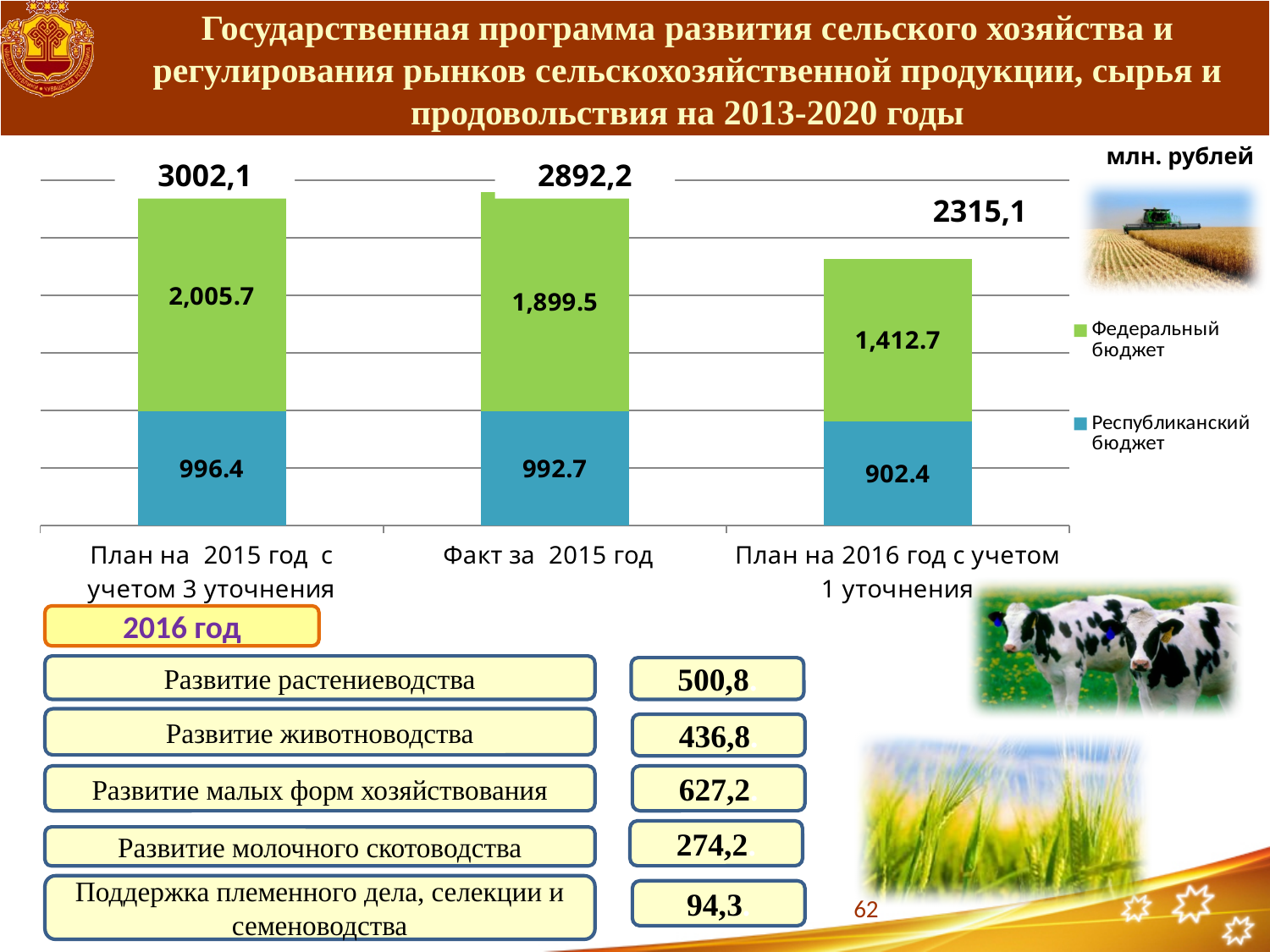
What is the value of Федеральный бюджет for План на 2016 год с учетом 1 уточнения? 1,412.7 What kind of chart is shown on the slide? stacked bar chart What is the value of Республиканский бюджет for Факт за 2015 год? 992.7 Which is larger: Федеральный бюджет for Факт за 2015 год or Федеральный бюджет for План на 2016 год с учетом 1 уточнения? Факт за 2015 год What is the total shown above the bar for Факт за 2015 год? 2892,2 What is the difference between the Республиканский бюджет values for Факт за 2015 год and План на 2016 год с учетом 1 уточнения? 90.3 Which category has the lowest total? План на 2016 год с учетом 1 уточнения How many categories are shown on the x axis of the chart? 3 Which category has the highest value for Республиканский бюджет? План на 2015 год с учетом 3 уточнения What is the value of Федеральный бюджет for План на 2015 год с учетом 3 уточнения? 2,005.7 How many series does the chart legend list? 2 Do the bar totals rise or fall from left to right across the chart? fall